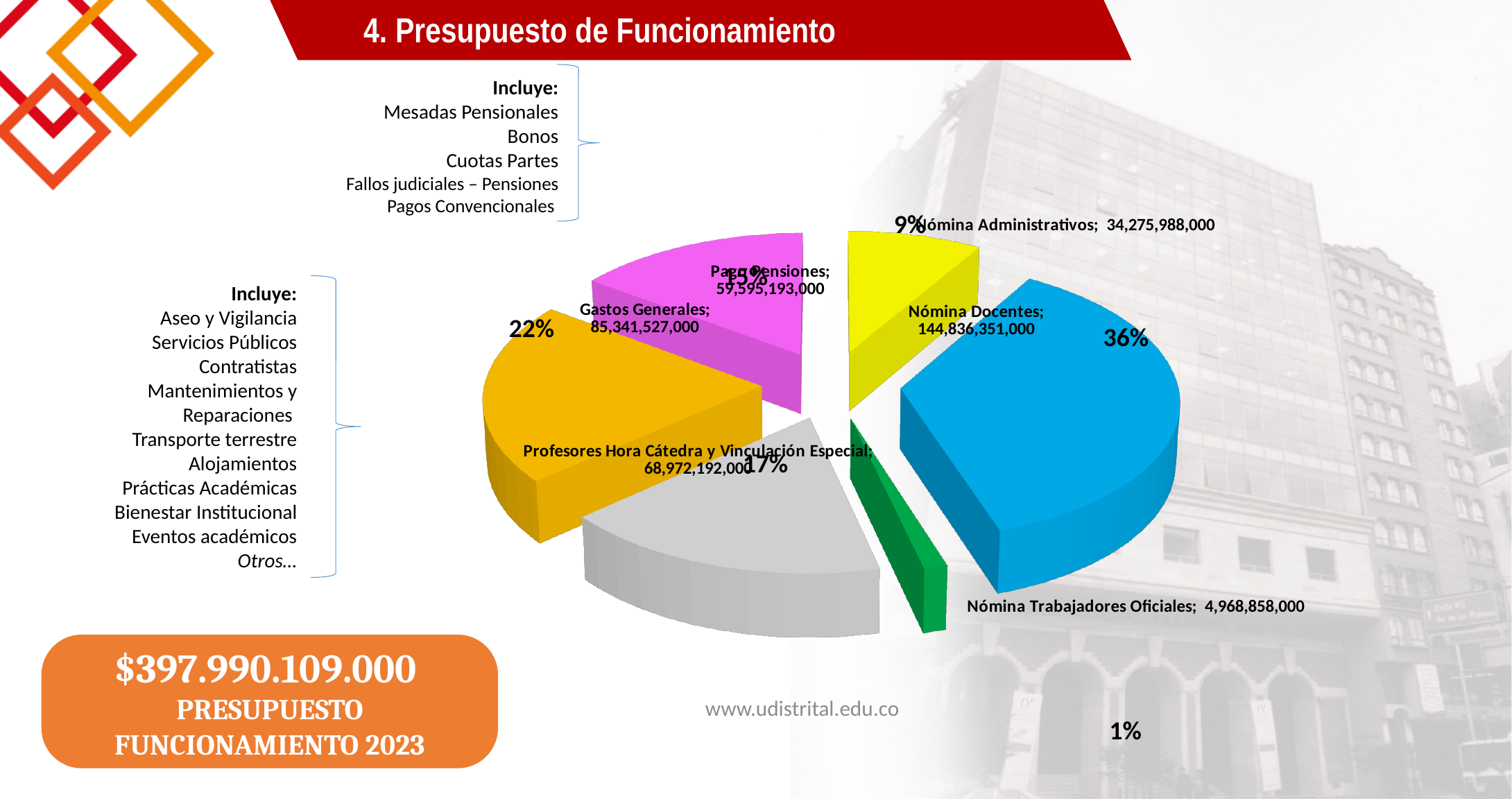
What is the value for Profesores Hora Cátedra y Vinculación Especial in the pie chart? 68,972,192,000 What percentage share of the pie does Gastos Generales represent? 22% Which is larger, Gastos Generales or Pago Pensiones? Gastos Generales Which category has the largest slice in the pie chart? Nómina Docentes How many slices does the pie chart have? 6 What type of chart is shown on the slide? Pie chart Which category has the smallest slice in the pie chart? Nómina Trabajadores Oficiales What is the value for Gastos Generales in the pie chart? 85,341,527,000 What is the value for Nómina Administrativos in the pie chart? 34,275,988,000 What is the value for Nómina Docentes in the pie chart? 144,836,351,000 What percentage share of the pie does Nómina Docentes represent? 36% What is the value for Nómina Trabajadores Oficiales in the pie chart? 4,968,858,000